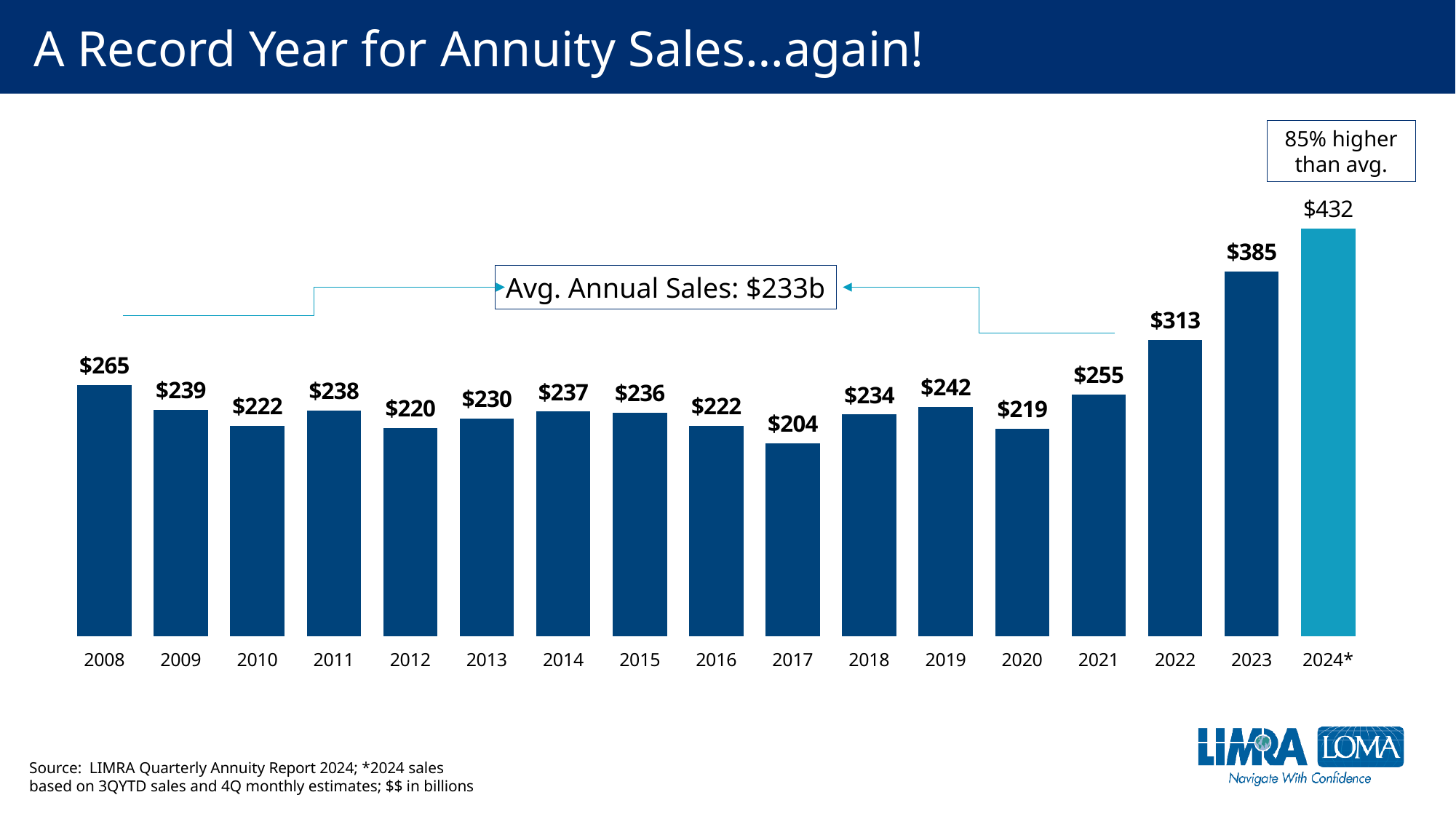
Which is larger, the value for 2022 or the value for 2021? 2022 Do the values rise or fall from 2020 to 2024*? Rise What is the annuity sales value shown for 2017? $204 How many years are shown on the x axis? 17 What is the annuity sales value shown for 2008? $265 What average annual sales figure is shown in the callout box on the chart? $233b According to the annotation above the 2024* bar, how much higher than average is the 2024* value? 85% higher than avg. Which year has the lowest annuity sales value? 2017 What is the difference between the 2024* value and the 2023 value? $47 Which year has the highest annuity sales value? 2024* What is the annuity sales value shown for 2023? $385 What kind of chart is shown on the slide? Bar chart